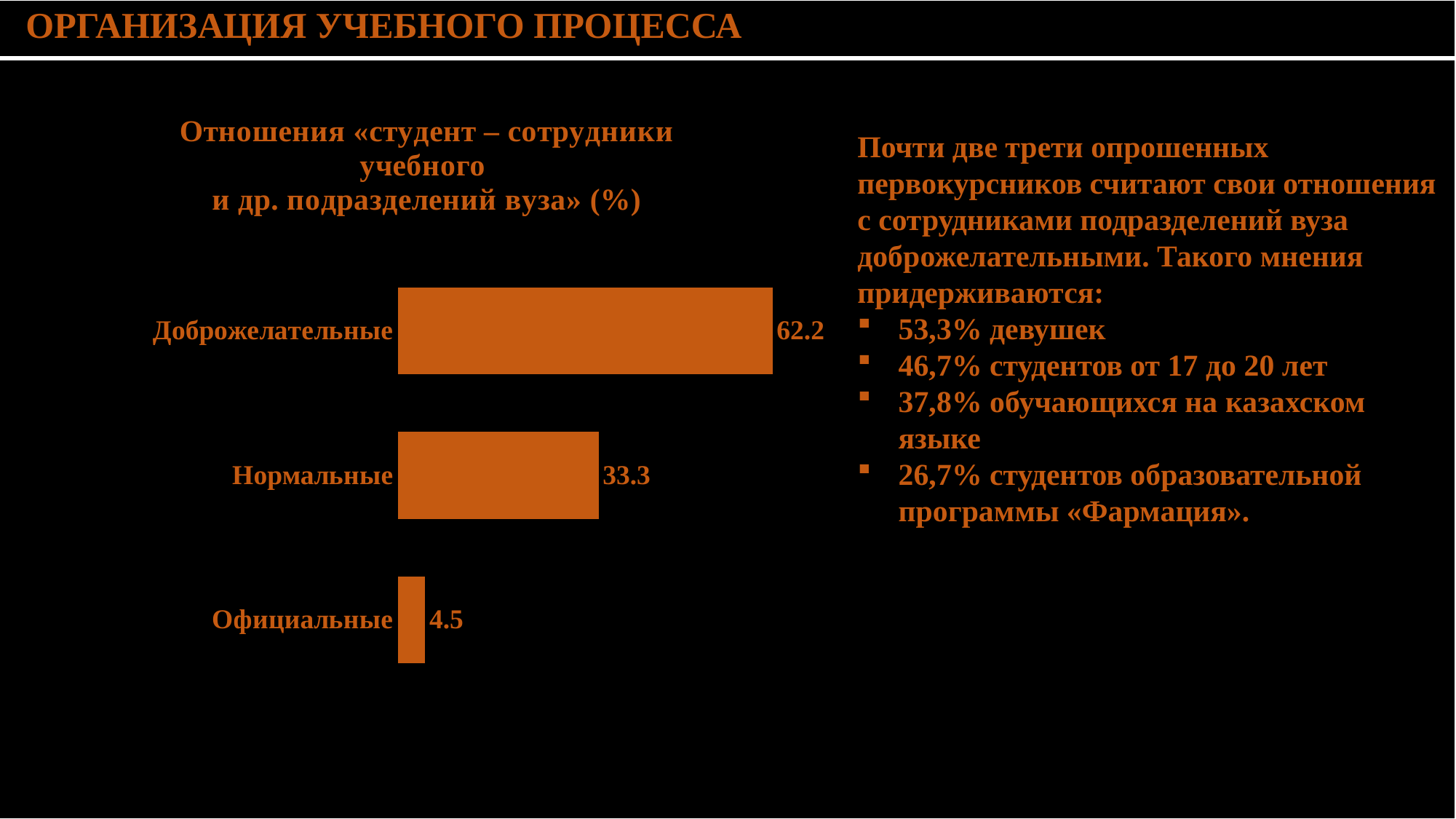
What is the difference between the values for Нормальные and Официальные? 28.8 Which category has the lowest value? Официальные What colour are the bars in the chart? orange What is the value for Доброжелательные? 62.2 What is the value for Официальные? 4.5 What kind of chart is shown on the slide? bar chart Which is larger, the value for Нормальные or the value for Официальные? Нормальные Which category has the highest value? Доброжелательные What is the total of the three values shown in the chart? 100 What is the value for Нормальные? 33.3 How many categories are shown in the chart? 3 What is the difference between the values for Доброжелательные and Нормальные? 28.9